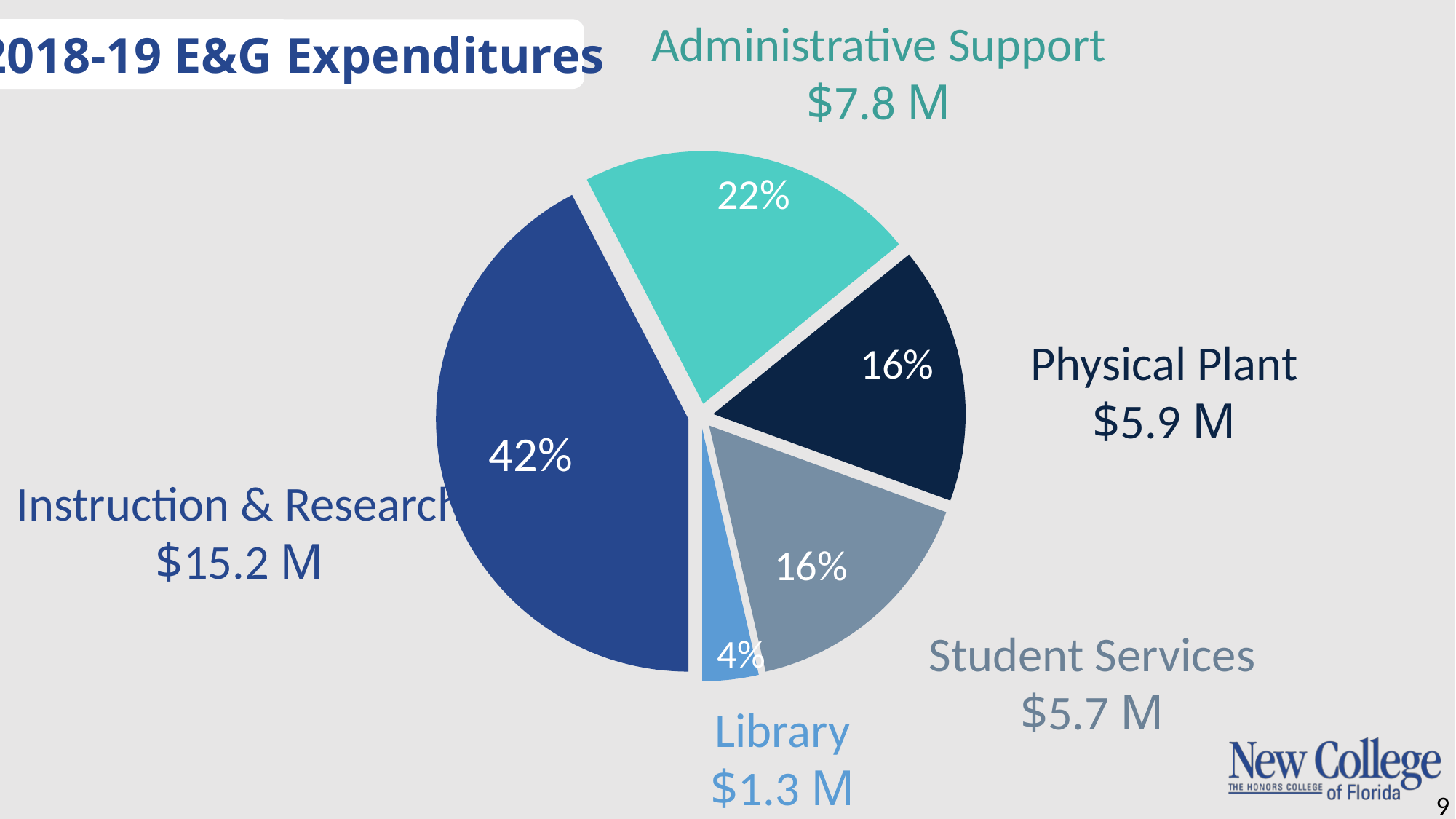
What is the expenditure amount for Library? $1.3 M What share of the pie does Administrative Support represent? 22% What is the expenditure amount for Administrative Support? $7.8 M What is the difference in expenditure between Instruction & Research and Administrative Support? $7.4 M How many slices does the pie chart have? 5 What is the expenditure amount for Instruction & Research? $15.2 M What is the title of the chart? 2018-19 E&G Expenditures Which has the larger expenditure, Physical Plant or Student Services? Physical Plant Which category has the smallest expenditure? Library Which category has the largest expenditure? Instruction & Research What share of the pie does Instruction & Research represent? 42% What kind of chart is shown on the slide? pie chart